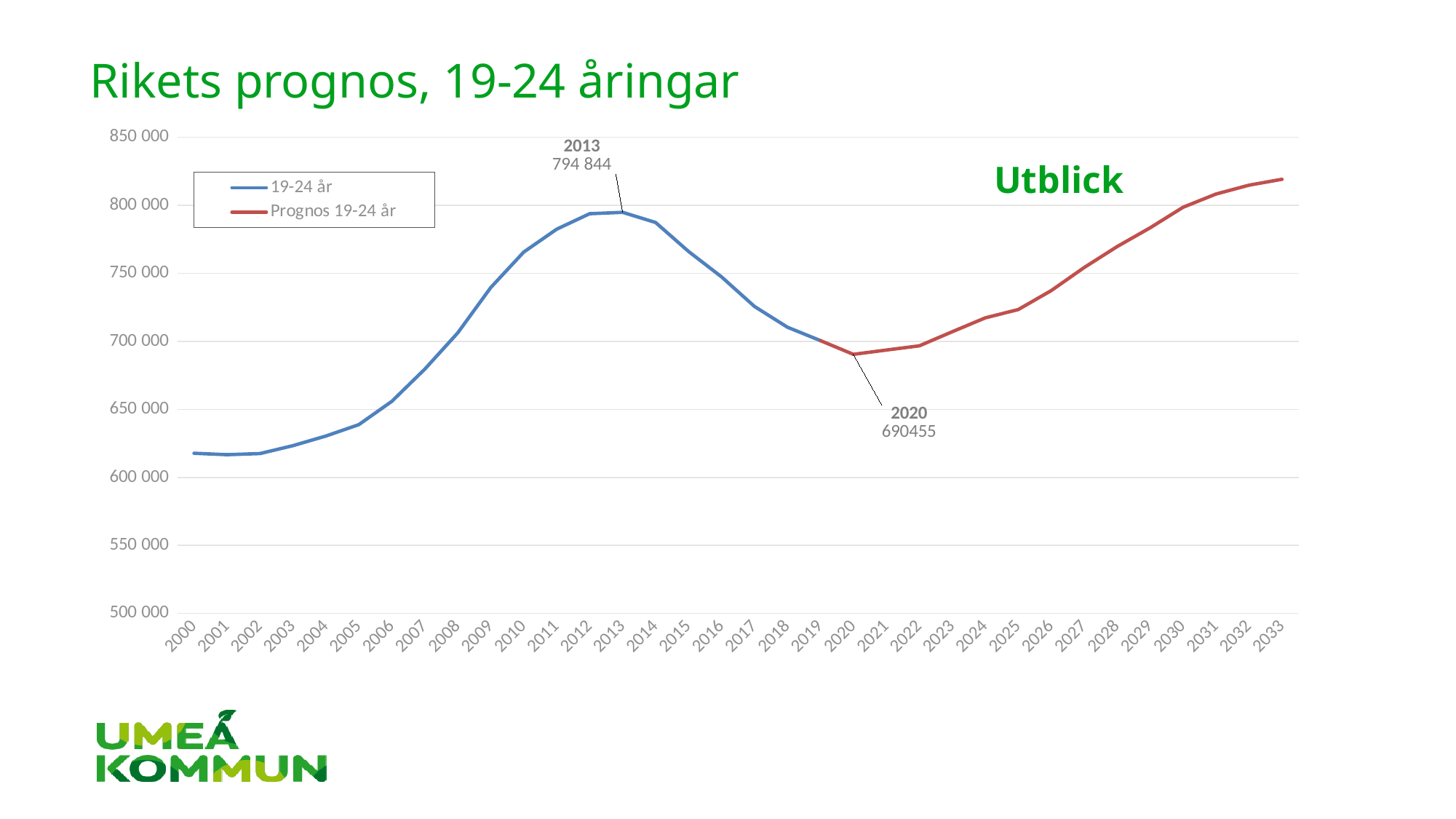
What is the difference between the labelled values for 2013 and 2020? 104 389 What kind of chart is shown on the slide? line chart Is the value for 2033 greater or less than 800 000? greater Do the values rise or fall from 2020 to 2033? rise What is the value labelled for 2013? 794 844 Which of the two labelled values, 2013 or 2020, is larger? 2013 Which year has the lowest value in the Prognos 19-24 år series? 2020 How many years are shown on the x axis? 34 Is the value for 2010 greater or less than 750 000? greater How many series does the legend list? 2 What is the value labelled for 2020? 690455 Is the value for 2000 greater or less than 650 000? less